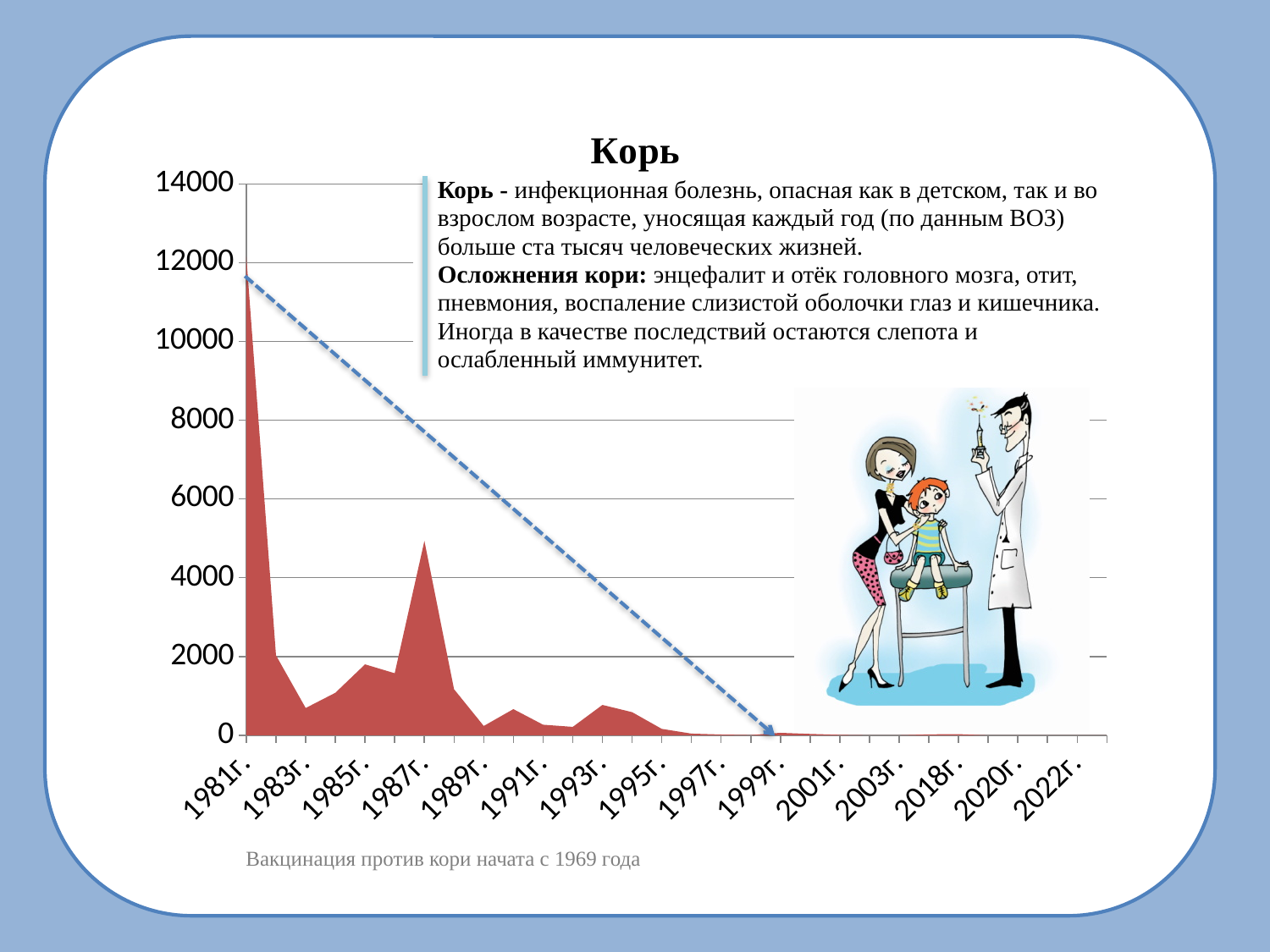
Which is larger, the value for 1981г. or the value for 1987г.? 1981г. Which is larger, the value for 1987г. or the value for 1993г.? 1987г. Which year has the highest value on the chart? 1981г. What kind of chart is shown on the slide? area chart Is the value for 1989г. greater or less than 2000? less Is the value for 1983г. greater or less than 2000? less Is the value for 1981г. greater or less than 10000? greater Do the values generally rise or fall from 1981г. to 2022г.? fall What is the title of the chart? Корь What is the highest value shown on the vertical axis? 14000